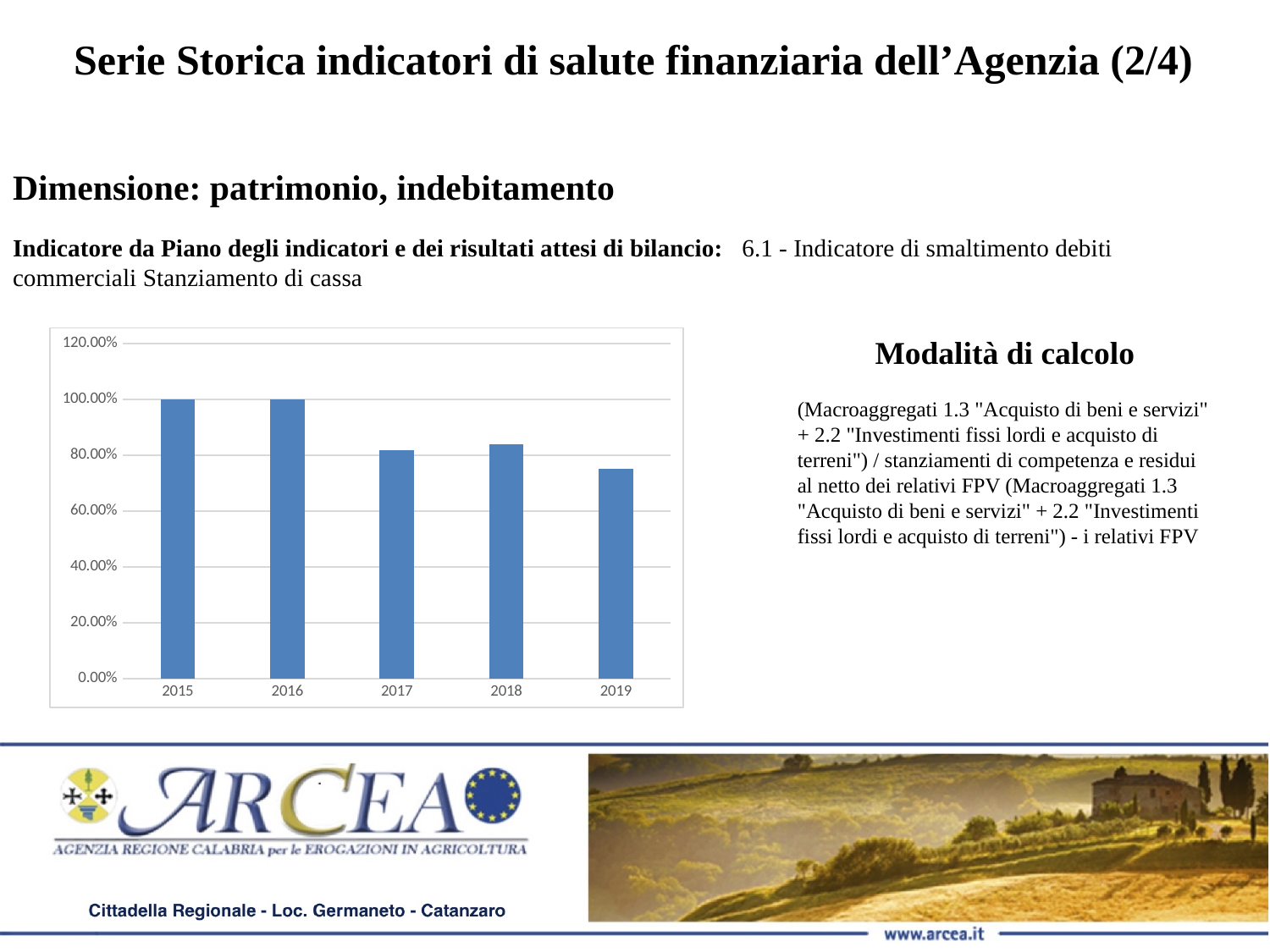
What is the value for 2015? 100.00% Which year has the lowest value? 2019 Which is larger, the value for 2018 or the value for 2019? 2018 Is the value for 2019 greater or less than 60.00%? greater What is the value for 2016? 100.00% What kind of chart is shown on the slide? bar chart Which is larger, the value for 2016 or the value for 2019? 2016 Is the value for 2019 greater or less than 80.00%? less What is the highest value shown on the y axis of the chart? 120.00% How many years are shown on the x axis of the chart? 5 Do the values generally rise or fall from 2015 to 2019? fall